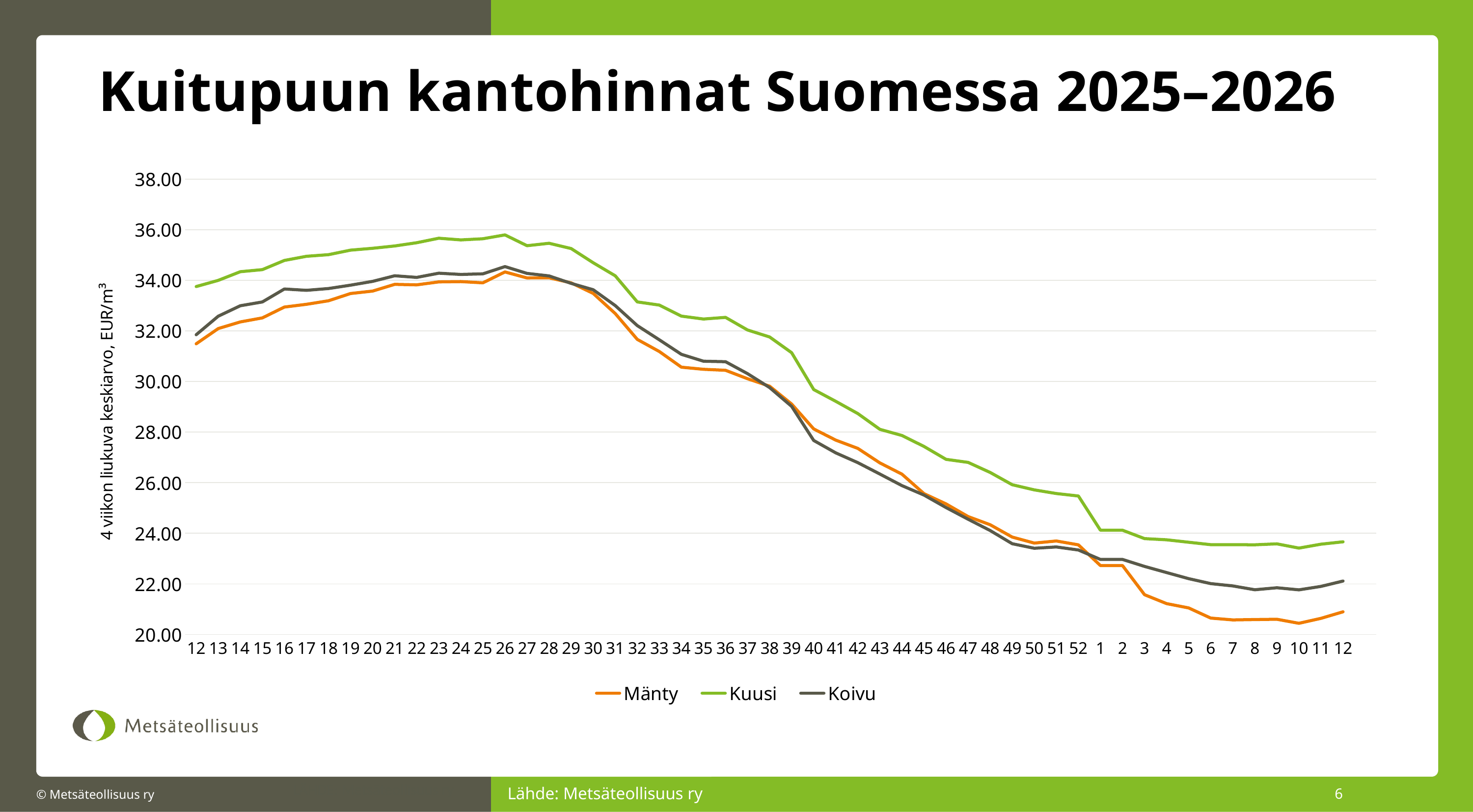
Is the value for Kuusi at week 52 greater or less than 24.00? greater At week 26, which is larger, the value for Kuusi or the value for Mänty? Kuusi Is the value for Mänty at the final week 12 greater or less than 22.00? less At the final week 12, which is larger, the value for Koivu or the value for Mänty? Koivu What are the three series named in the legend? Mänty, Kuusi, Koivu What is the title of the chart on the slide? Kuitupuun kantohinnat Suomessa 2025–2026 Do the values for Mänty rise or fall from week 30 to week 52? fall Is the value for Kuusi at week 26 greater or less than 34.00? greater How many series does the legend list? 3 What kind of chart is shown on the slide? line chart Which series has the highest value at week 30? Kuusi